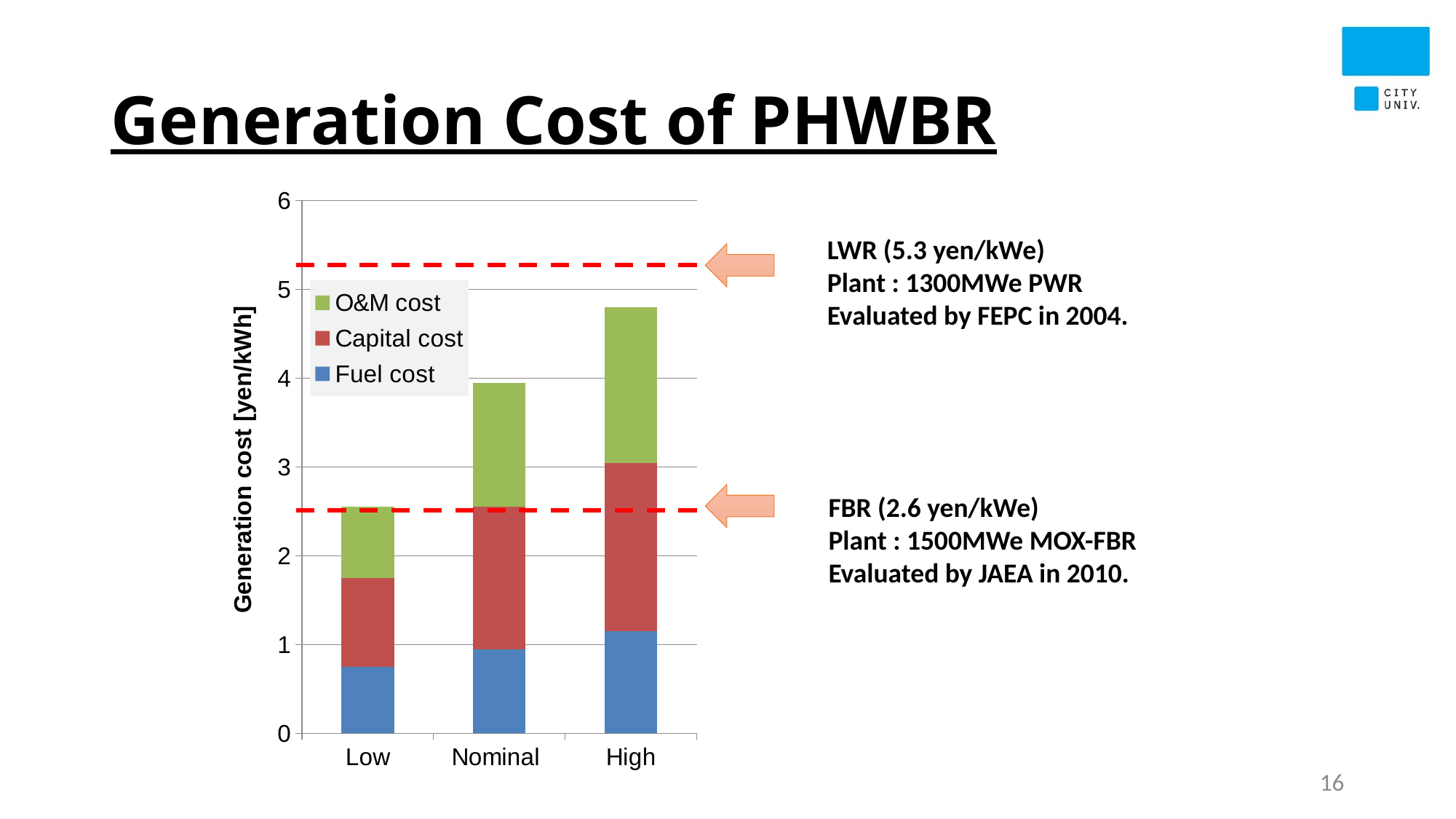
How many categories are shown on the x axis of the chart? 3 What kind of chart is shown on the slide? Stacked bar chart Is the Fuel cost for Low greater or less than 1? less Which has a larger total generation cost, Nominal or High? High Do the total generation costs rise or fall from Low to High along the x axis? Rise Which category has the highest total generation cost? High Is the total generation cost for Nominal greater or less than 3? greater Is the total generation cost for High greater or less than 4? greater How many series does the chart legend list? 3 What is the label of the y axis of the chart? Generation cost [yen/kWh] Which category has the lowest total generation cost? Low